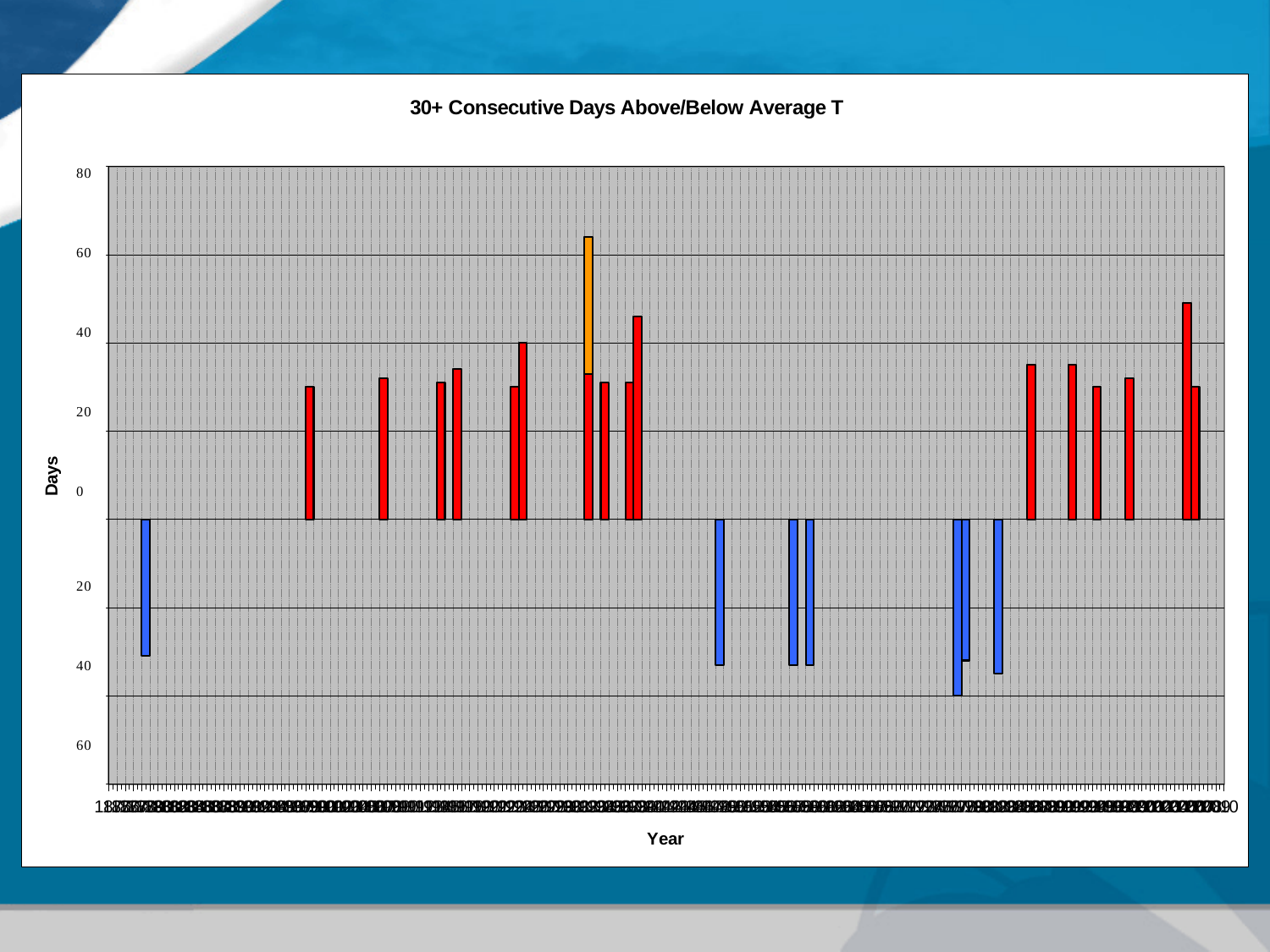
How many blue bars (below-average runs) are plotted on the chart? 7 What is the label on the vertical axis of the chart? Days Which extends further from the zero line: the tallest bar above the line or the longest bar below the line? The tallest bar above the line Is the value of the tallest red bar (near the right side of the chart) greater or less than 40 days? greater What colour are the bars that extend below the zero line? Blue Is the value of the tallest bar above the zero line (the orange bar) greater or less than 60 days? greater What is the title of the chart? 30+ Consecutive Days Above/Below Average T What kind of chart is shown on the slide? Bar chart